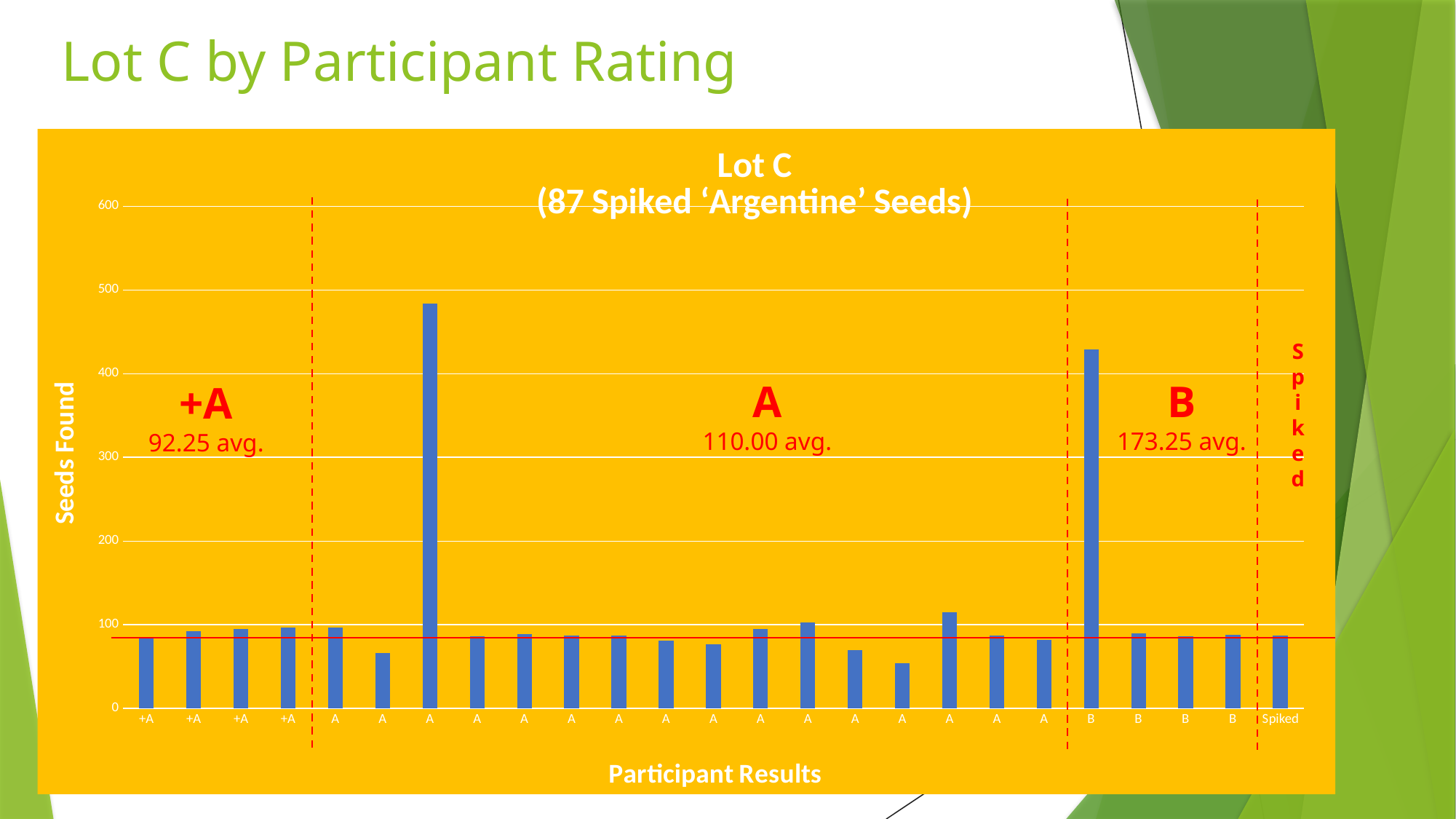
What is the average seeds found shown for the A group? 110.00 avg. What is the title of the chart? Lot C (87 Spiked 'Argentine' Seeds) What is the average seeds found shown for the B group? 173.25 avg. Is the tallest bar in the A group greater or less than 400? greater How many participants are rated B in the chart? 4 What kind of chart is shown on the slide? bar chart How many bars are plotted in the chart? 25 Is the value for the Spiked bar greater or less than 100? less Which rating group has the highest average seeds found? B What is the label on the vertical axis of the chart? Seeds Found How many participants are rated +A in the chart? 4 What is the average seeds found shown for the +A group? 92.25 avg.